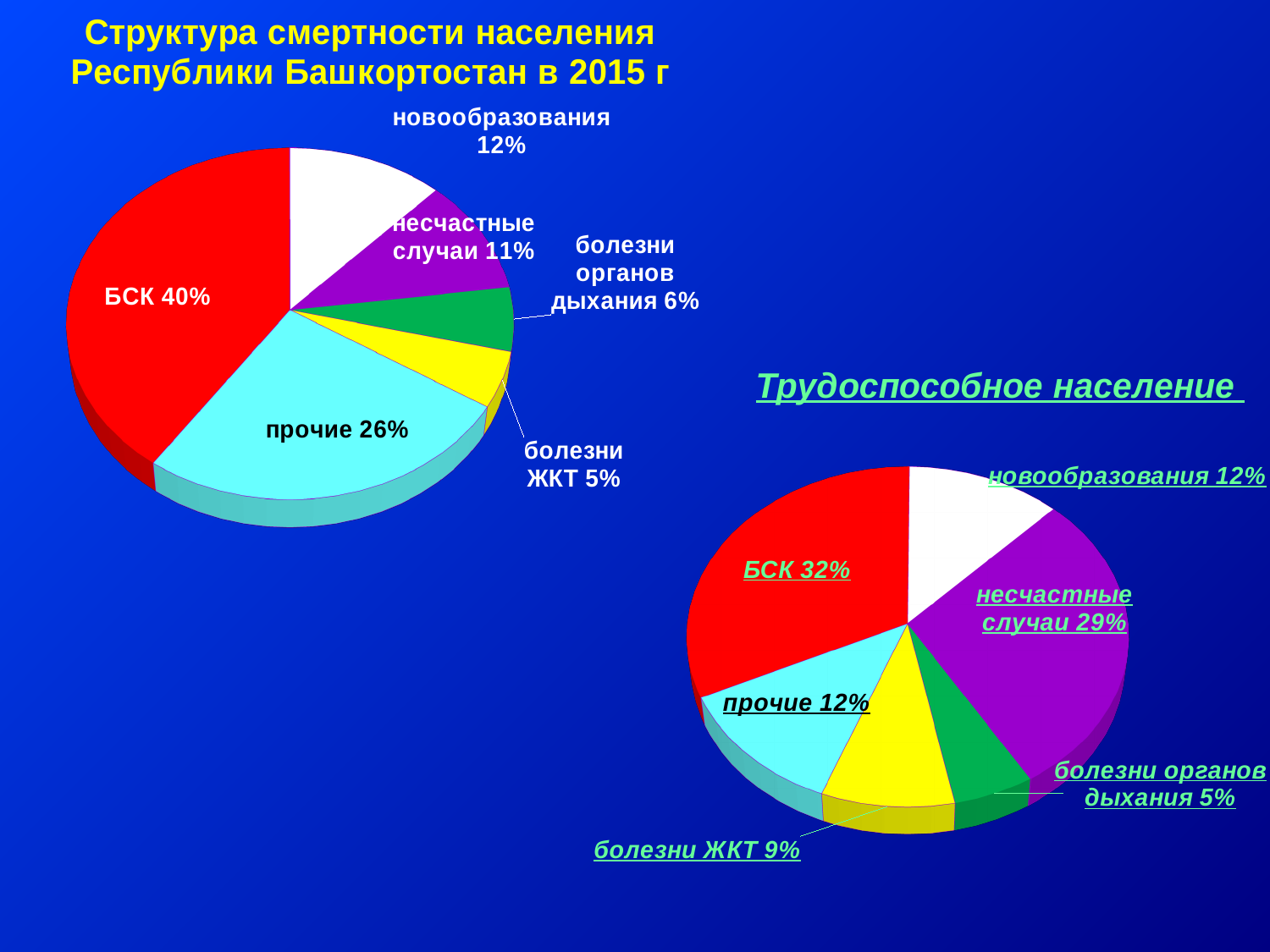
How many slices does the left pie chart have? 6 What is the title of the right chart? Трудоспособное население In the right pie chart, which is larger: the share of несчастные случаи or the share of прочие? несчастные случаи In the left pie chart, what is the difference between the shares of БСК and прочие? 14% In the right pie chart, which category has the smallest share? болезни органов дыхания In the left pie chart (Структура смертности населения Республики Башкортостан в 2015 г), what share is labelled for БСК? 40% In the left pie chart, which category has the smallest share? болезни ЖКТ In the right pie chart, which category has the largest share? БСК In the right pie chart, what share is labelled for болезни ЖКТ? 9% What type of chart is used on this slide? Pie chart In the left pie chart, what share is labelled for прочие? 26% In the right pie chart (Трудоспособное население), what share is labelled for несчастные случаи? 29%